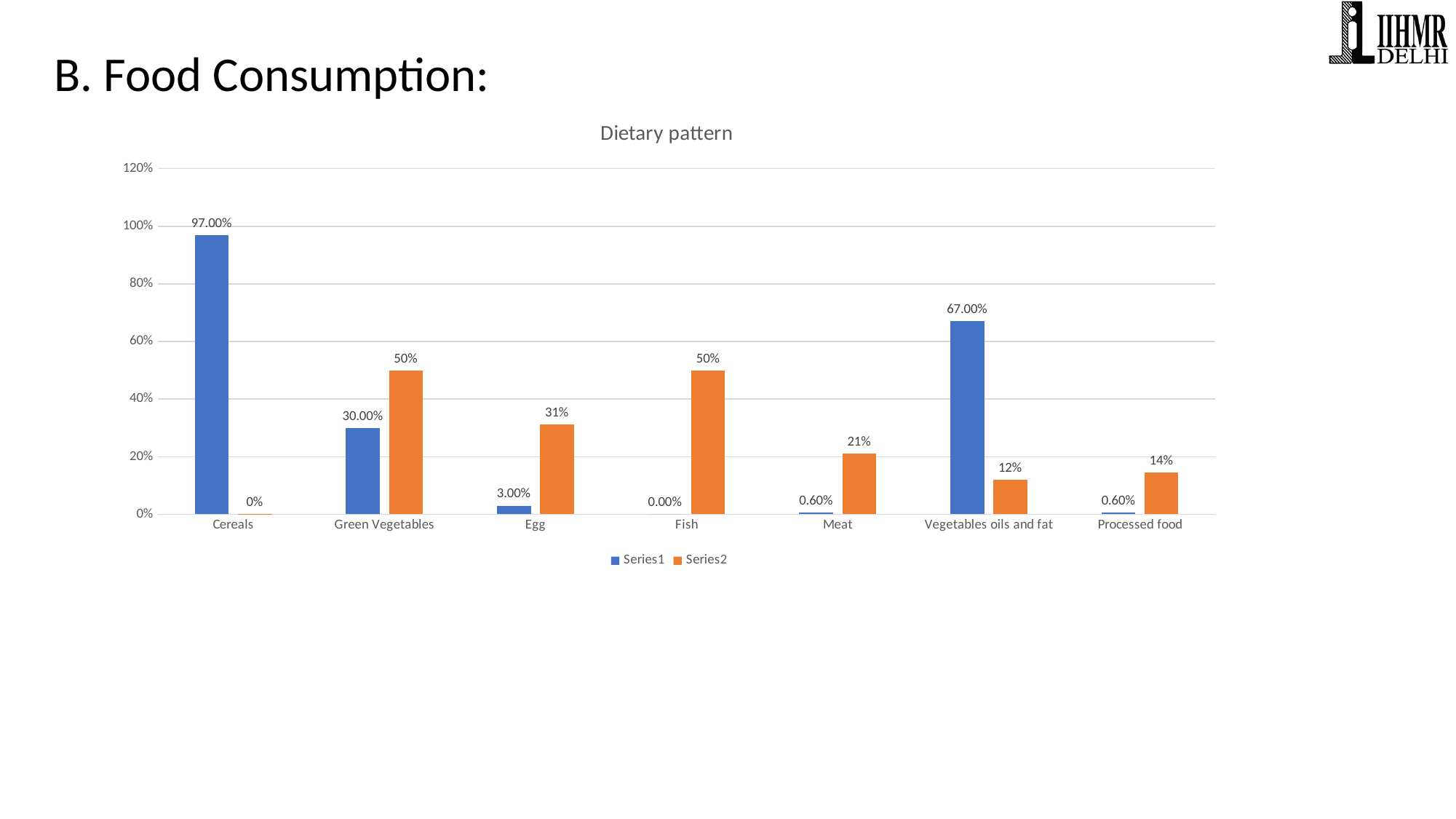
What is the Series1 value for Vegetables oils and fat? 67.00% What is the title of the chart? Dietary pattern What is the difference between the Series2 values for Fish and Meat? 29% What kind of chart is shown on the slide? Bar chart Which is larger for Green Vegetables: Series1 or Series2? Series2 What is the Series1 value for Cereals? 97.00% Which category has the lowest Series1 value? Fish What is the Series2 value for Egg? 31% How many series does the legend list? 2 What is the Series2 value for Processed food? 14% Which category has the highest Series1 value? Cereals How many categories are shown on the x axis? 7